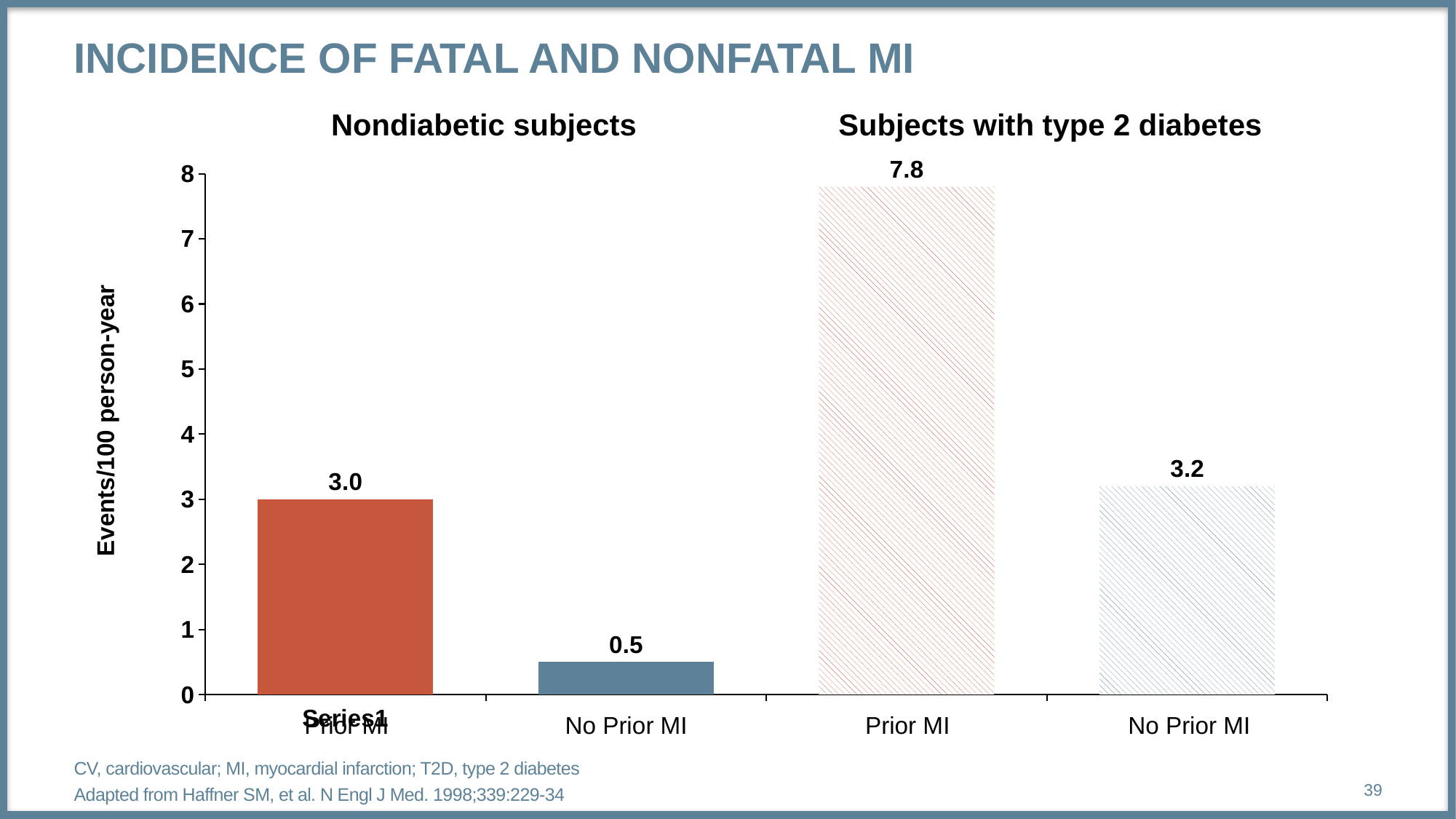
What is the value for Prior MI among subjects with type 2 diabetes? 7.8 What is the value for Prior MI among nondiabetic subjects? 3.0 Which bar has the highest value? Prior MI, subjects with type 2 diabetes What is the value for No Prior MI among nondiabetic subjects? 0.5 Which is larger: No Prior MI among subjects with type 2 diabetes or Prior MI among nondiabetic subjects? No Prior MI among subjects with type 2 diabetes What is the value for No Prior MI among subjects with type 2 diabetes? 3.2 What is the label of the vertical axis? Events/100 person-year What kind of chart is shown on the slide? Bar chart What is the difference between the Prior MI and No Prior MI values among nondiabetic subjects? 2.5 Which bar has the lowest value? No Prior MI, nondiabetic subjects What is the difference between the Prior MI values for subjects with type 2 diabetes and nondiabetic subjects? 4.8 How many bars are plotted on the chart? 4